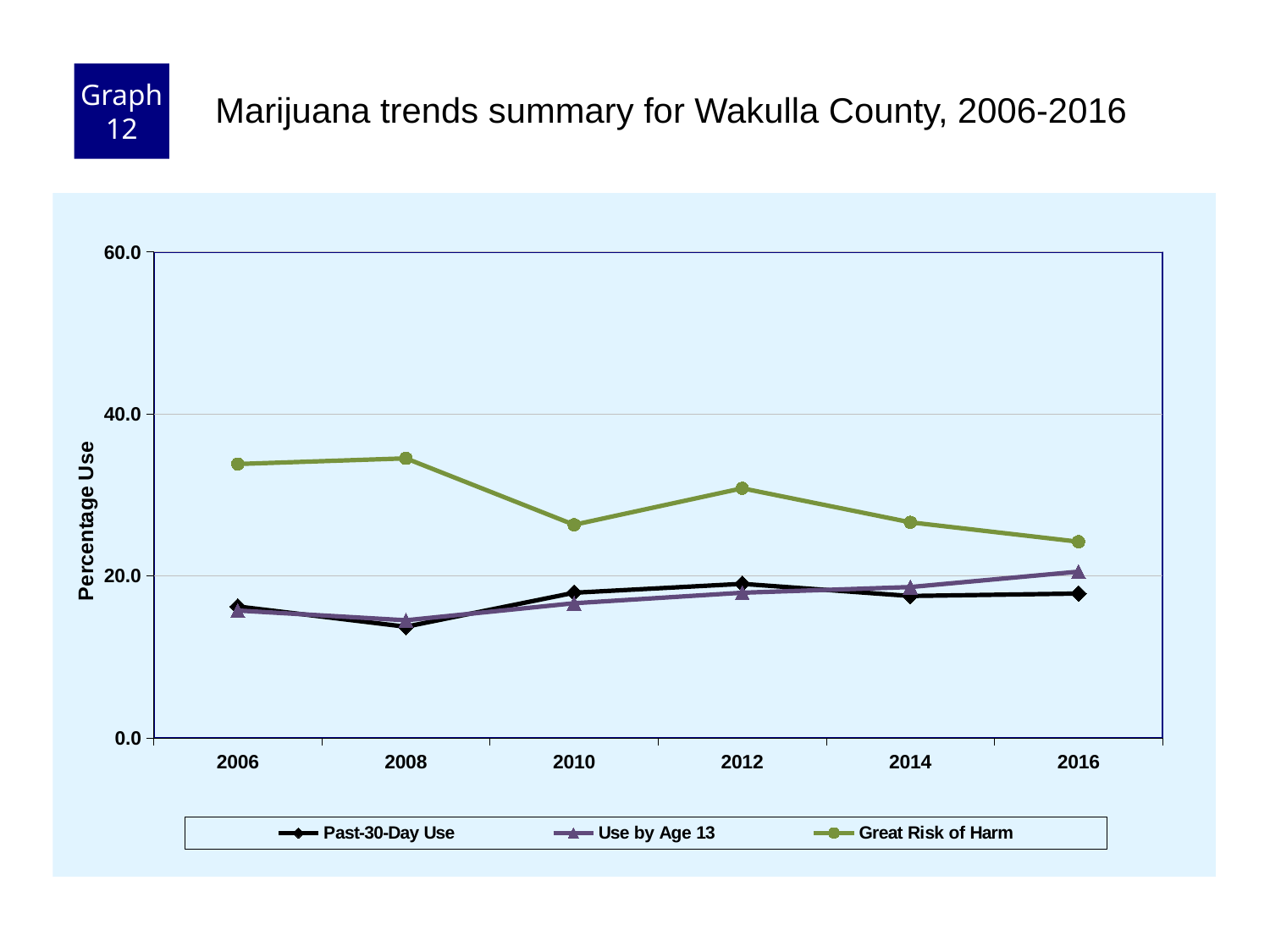
In which year is Past-30-Day Use at its lowest? 2008 In which year is Great Risk of Harm at its lowest? 2016 Is the value for Great Risk of Harm in 2006 greater or less than 40.0? less Which series is plotted with the green line? Great Risk of Harm What kind of chart is shown on the slide? line chart Does the Great Risk of Harm line rise or fall overall from 2006 to 2016? fall What is the label on the y axis? Percentage Use In 2010, which is larger: Great Risk of Harm or Past-30-Day Use? Great Risk of Harm Is the value for Great Risk of Harm in 2008 greater or less than 20.0? greater How many years are plotted along the x axis? 6 How many series does the legend list? 3 Is the value for Past-30-Day Use in 2008 greater or less than 20.0? less